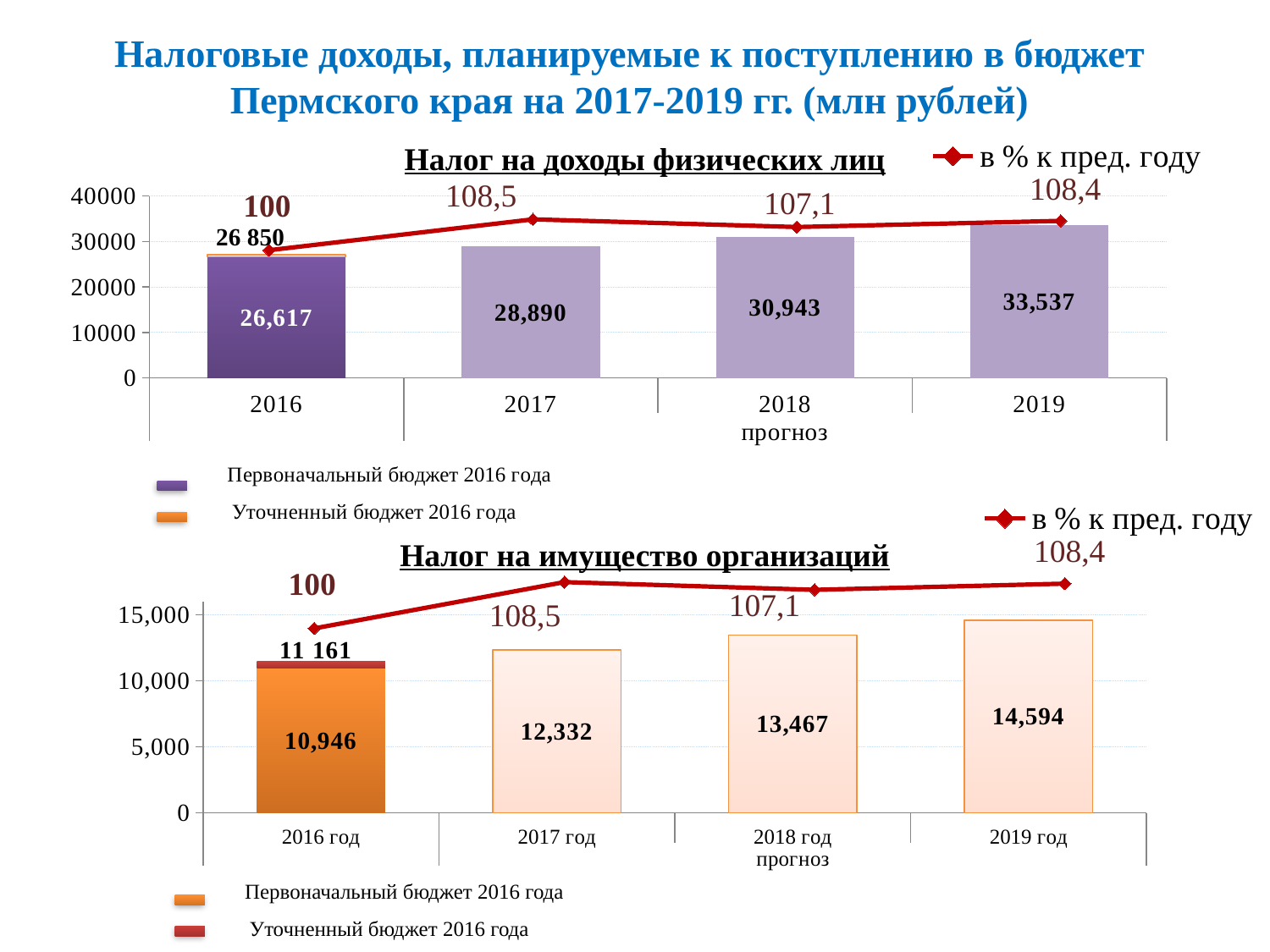
In the chart 'Налог на имущество организаций', which year has the lowest bar value? 2016 год In the chart 'Налог на имущество организаций', is the bar value for 2019 год greater or less than 15,000? less In the chart 'Налог на доходы физических лиц', what is the value labelled on the bar for 2017? 28,890 In the chart 'Налог на имущество организаций', what is the difference between the 2017 год bar value and the 2016 год bar value of 10,946? 1,386 In the chart 'Налог на доходы физических лиц', what is the value labelled on the bar for 2019? 33,537 In the chart 'Налог на доходы физических лиц', what is the difference between the 2019 bar value and the 2018 прогноз bar value? 2,594 What kind of chart is 'Налог на имущество организаций'? bar chart with a line In the chart 'Налог на доходы физических лиц', do the bar values rise or fall from 2016 to 2019? rise In the chart 'Налог на доходы физических лиц', which year has the highest bar value? 2019 In the chart 'Налог на имущество организаций', what is the value labelled on the bar for 2019 год? 14,594 In the chart 'Налог на доходы физических лиц', what is the value of the 'в % к пред. году' line for 2018 прогноз? 107,1 In the chart 'Налог на имущество организаций', what is the value labelled on the bar for 2018 год прогноз? 13,467